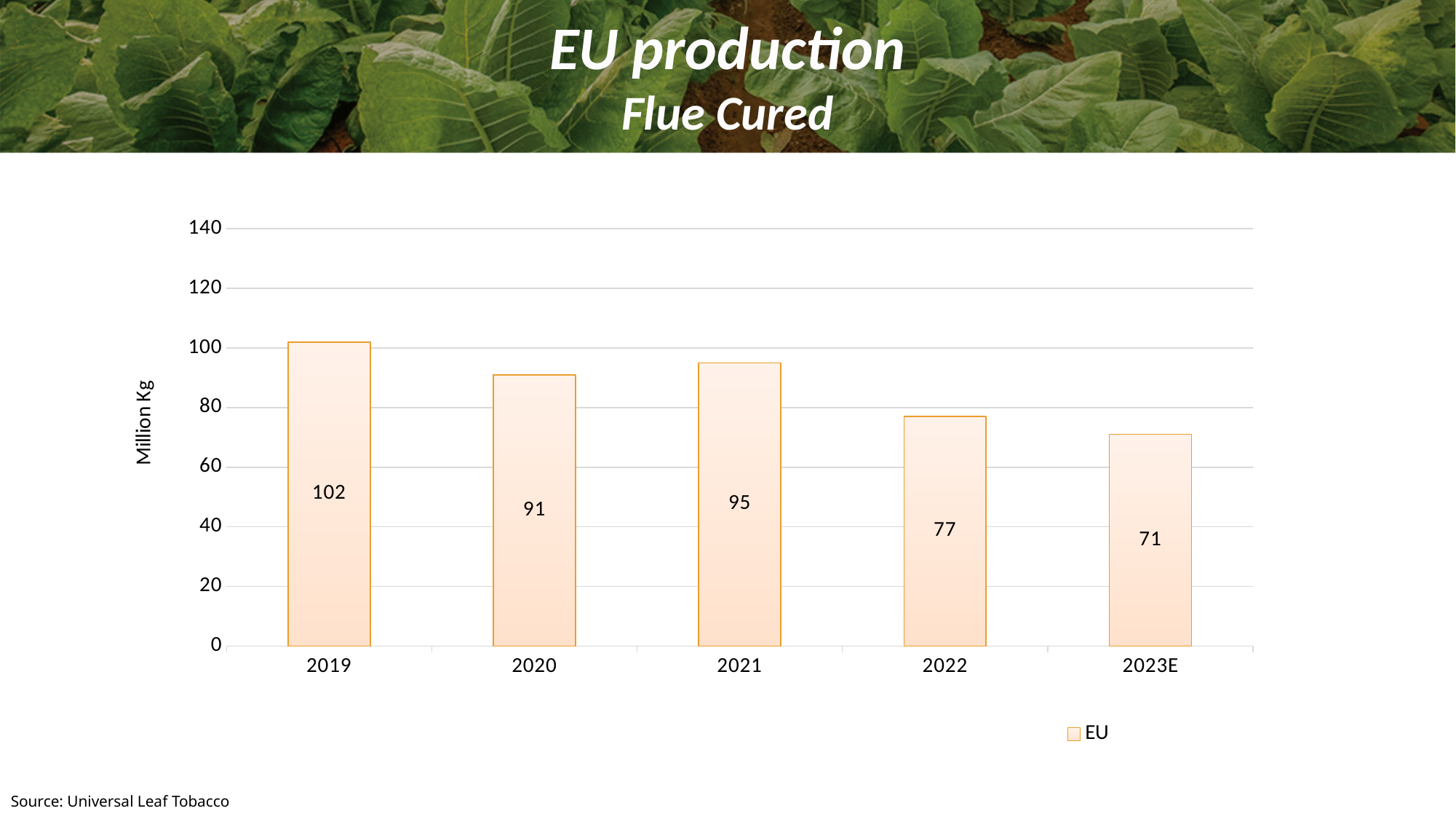
What is the EU flue cured production value for 2019? 102 What kind of chart is shown on the slide? bar chart Which is larger, the EU production value for 2020 or for 2021? 2021 Is the EU production value for 2022 greater or less than 80? less Which year has the highest EU flue cured production? 2019 What is the difference between the 2019 and 2023E EU production values? 31 What is the label on the vertical axis of the chart? Million Kg What is the EU flue cured production value for 2023E? 71 Which year has the lowest EU flue cured production? 2023E What is the difference between the 2020 and 2021 EU production values? 4 How many years are shown on the x axis of the chart? 5 What is the EU flue cured production value for 2022? 77